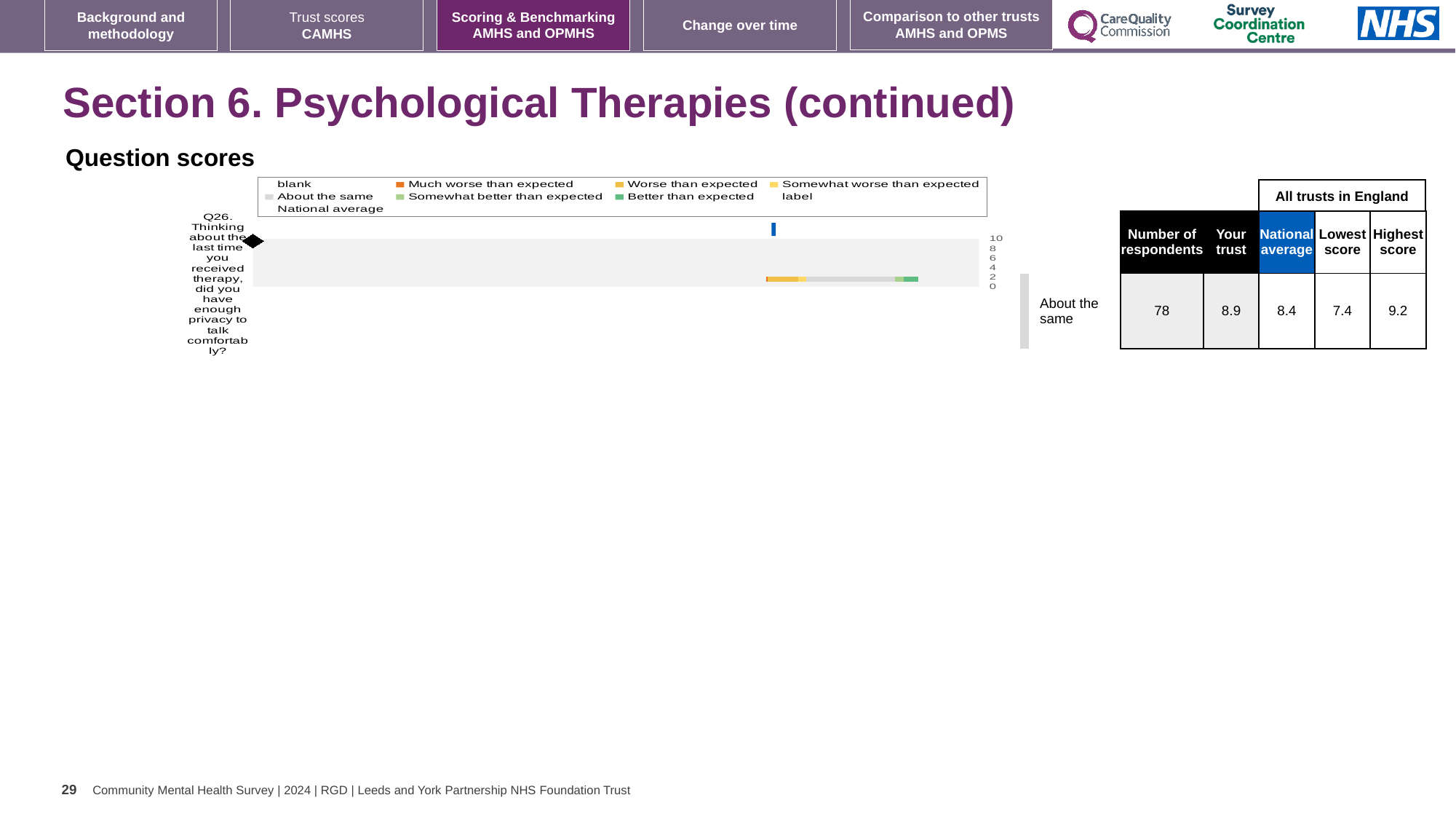
In the table next to the chart, what is the National average score for Q26? 8.4 In the table next to the chart, how many respondents answered Q26? 78 What is the highest tick value shown on the chart's axis? 10 What is the difference between the Highest score and the Lowest score for Q26 in the table? 1.8 What benchmark category is given for Q26 next to the chart? About the same In the table next to the chart, what is the Lowest score among all trusts in England for Q26? 7.4 How many questions (categories) are plotted on the chart? 1 Which is larger for Q26, the 'Your trust' score or the National average? Your trust In the table next to the chart, what is the 'Your trust' score for Q26? 8.9 What kind of chart is shown under 'Question scores'? bar chart In the table next to the chart, what is the Highest score among all trusts in England for Q26? 9.2 Which question is plotted on the chart? Q26. Thinking about the last time you received therapy, did you have enough privacy to talk comfortably?